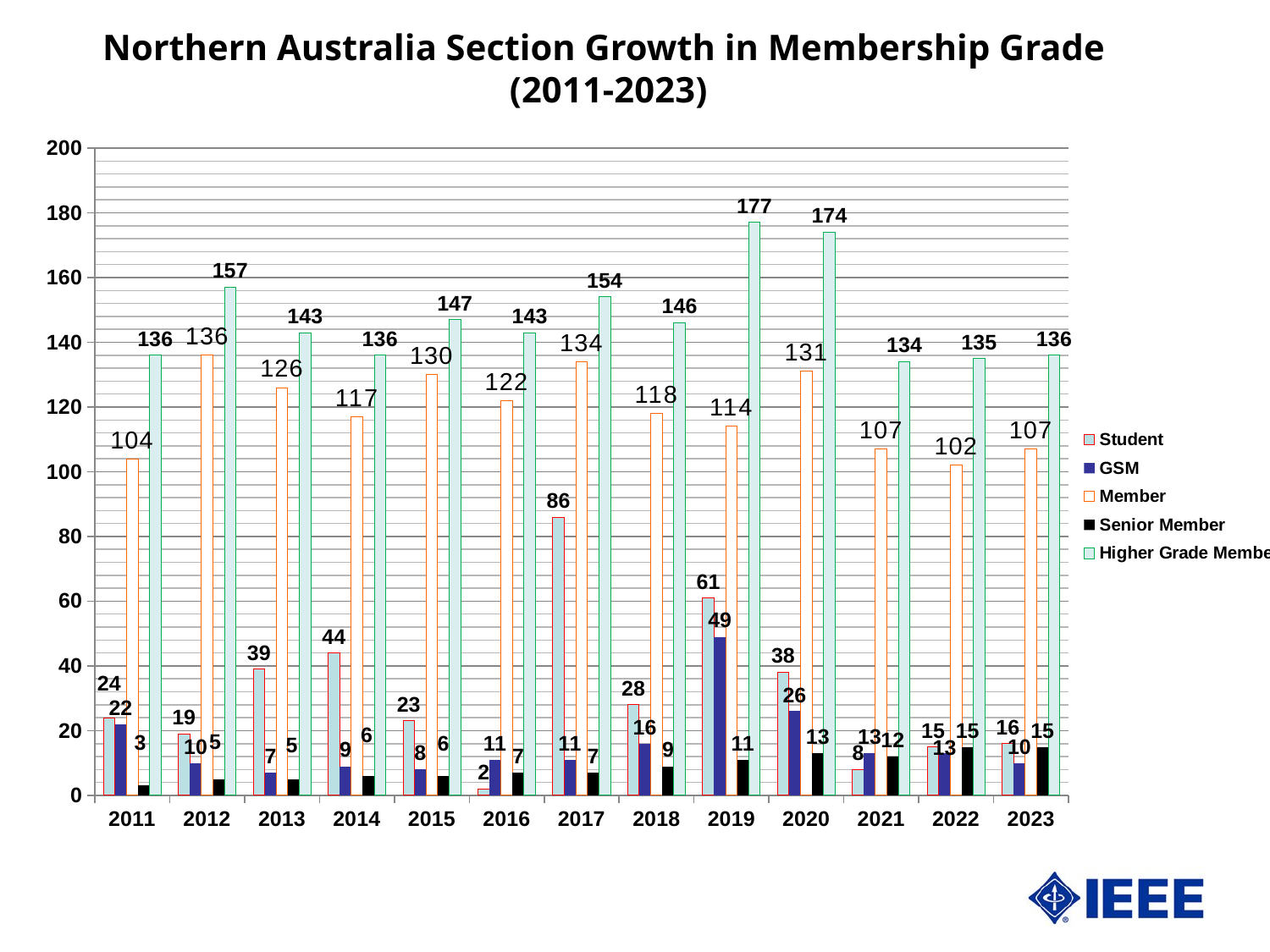
What kind of chart is shown on the slide? Bar chart How many years are shown on the x axis? 13 What is the Higher Grade Member value for 2019? 177 In which year is the Student value lowest? 2016 Which is larger, the Student value for 2019 or the Student value for 2020? Student value for 2019 What is the Senior Member value for 2023? 15 In which year is the Higher Grade Member value highest? 2019 How many series does the legend list? 5 What is the GSM value for 2019? 49 What is the Student value for 2017? 86 What is the Member value for 2022? 102 What is the difference between the Member values for 2012 and 2011? 32